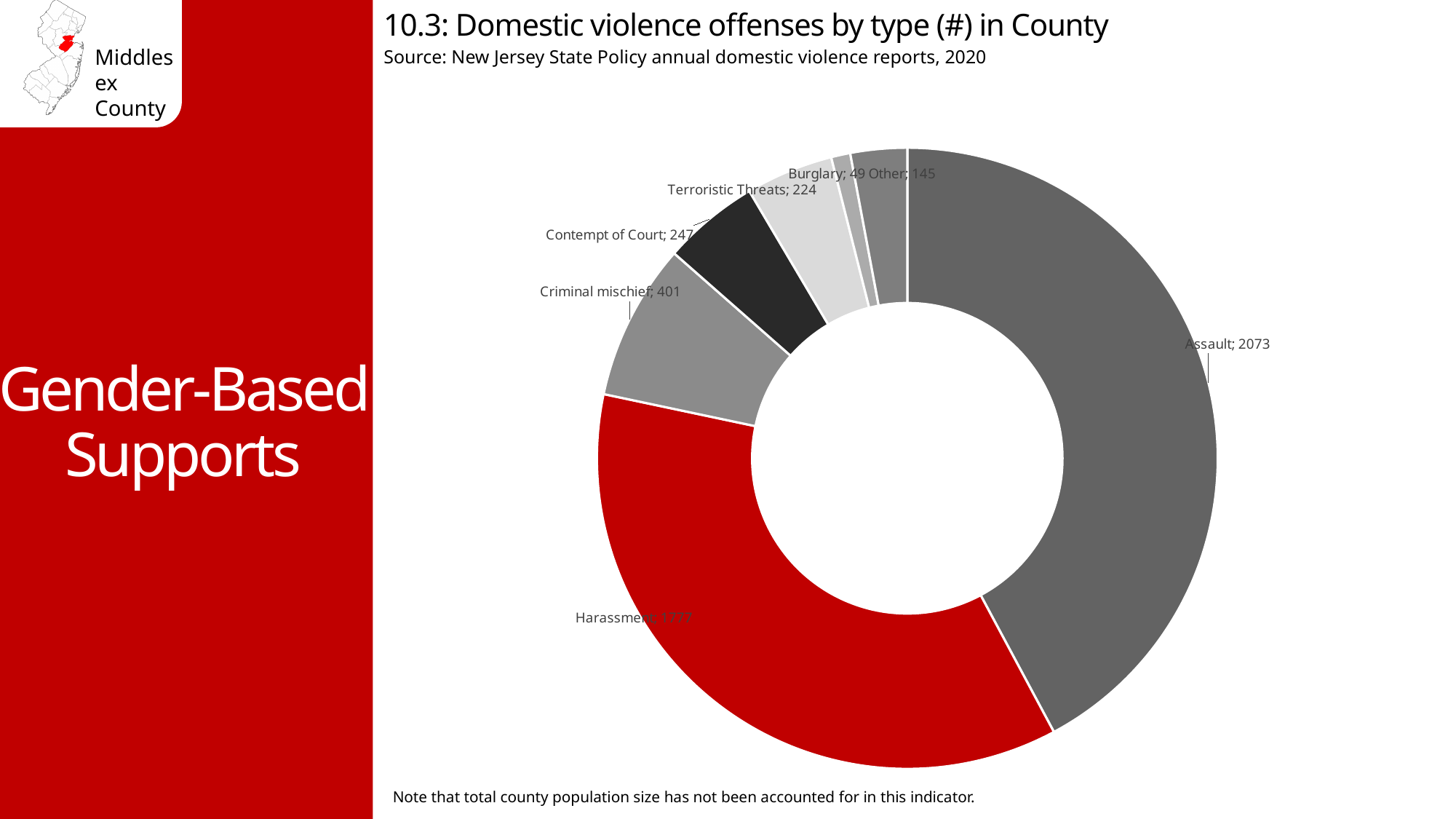
Which labeled offense type has the smallest value on the chart? Burglary Which offense type has the largest slice on the chart? Assault Which is larger, the value for Other or the value for Burglary? Other What is the number of Assault offenses shown on the chart? 2073 How many more Assault offenses than Harassment offenses are shown? 296 What value is shown for Criminal mischief? 401 What is the difference between the Criminal mischief and Contempt of Court values? 154 What value is shown for Burglary? 49 What is the number of Harassment offenses shown on the chart? 1777 What value is shown for Contempt of Court? 247 What value is shown for Terroristic Threats? 224 What type of chart is used on this slide? doughnut chart